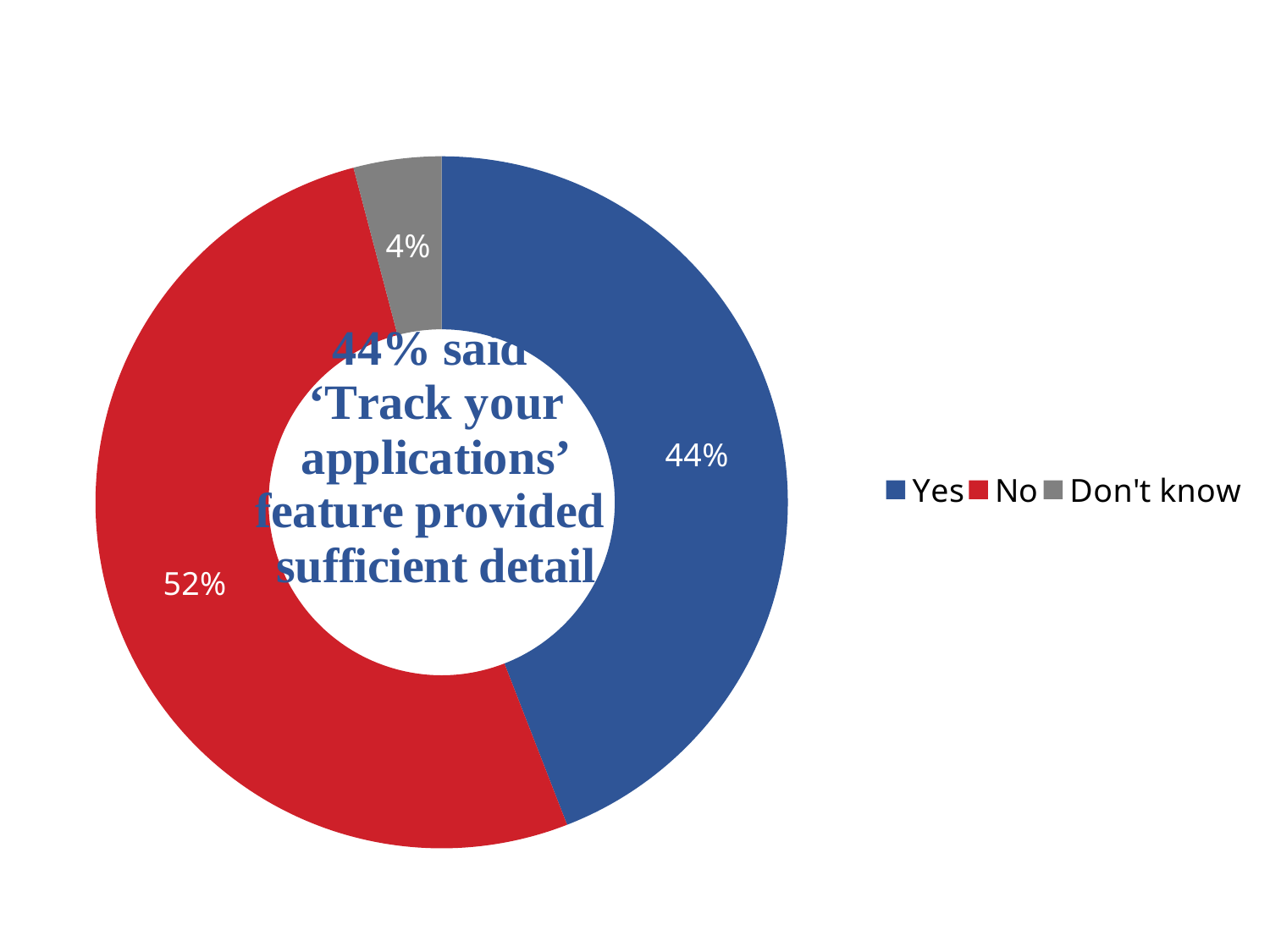
What colour represents the 'No' response? Red How many entries does the legend list? 3 How many categories does the chart show? 3 What is the difference in percentage points between 'No' and 'Yes'? 8 Which response has the largest share of the chart? No Which is larger, the share for 'Yes' or the share for 'No'? No What percentage of respondents answered 'Yes'? 44% What percentage of respondents answered 'Don't know'? 4% What percentage of respondents answered 'No'? 52% What kind of chart is shown on the slide? Pie chart (doughnut) What is the combined share of 'Yes' and 'Don't know'? 48% Which response has the smallest share of the chart? Don't know